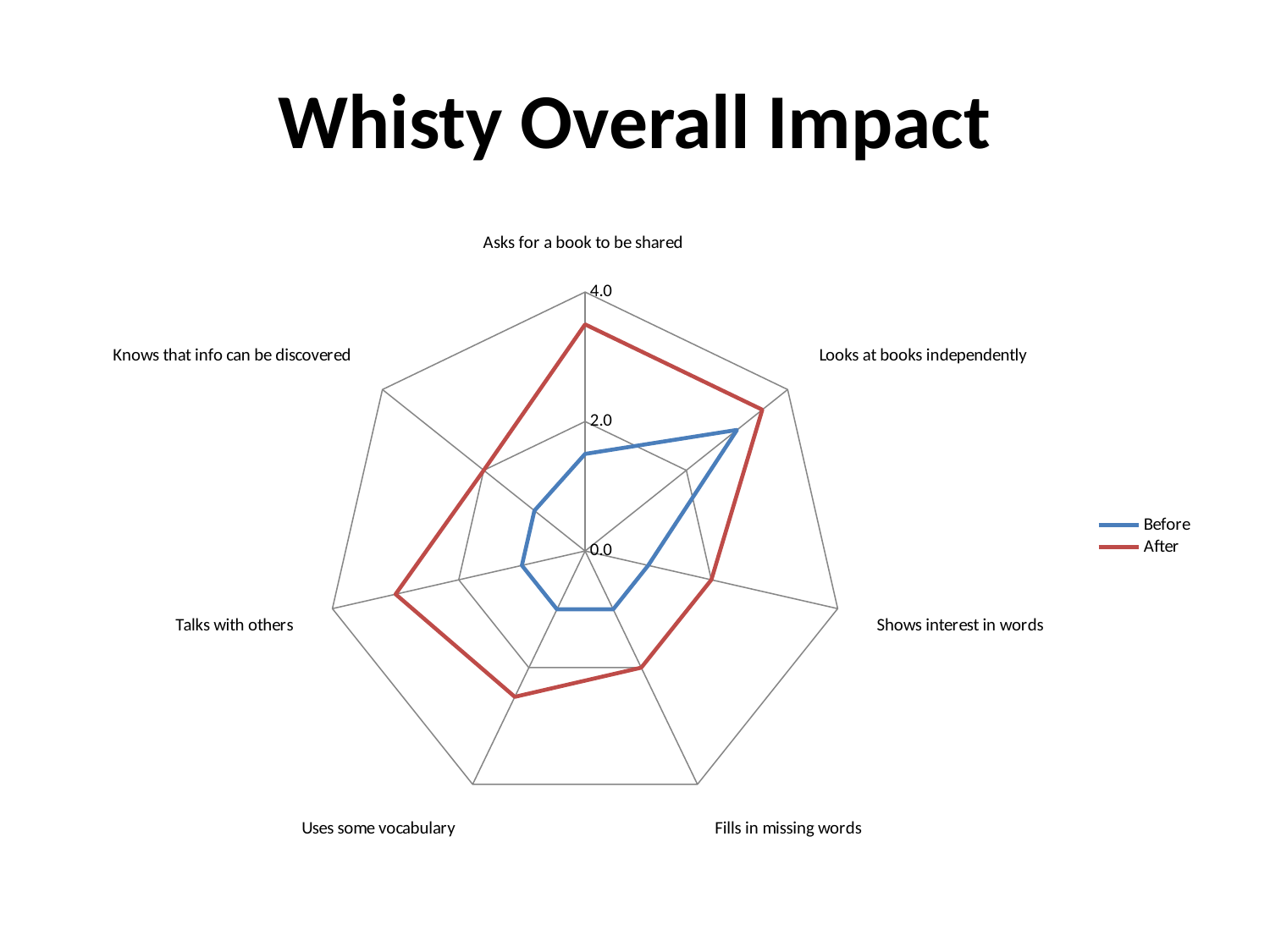
What is the title of the slide? Whisty Overall Impact Is the After value for 'Asks for a book to be shared' greater or less than 2.0? greater For the Before series, which category has the highest value? Looks at books independently How many categories (axes) does the radar chart have? 7 Is the Before value for 'Talks with others' greater or less than 2.0? less What kind of chart is shown on the slide? Radar chart Is the After value for 'Talks with others' greater or less than 2.0? greater What colour is the line for the After series? Red For 'Uses some vocabulary', which series has the larger value, Before or After? After How many series does the legend list? 2